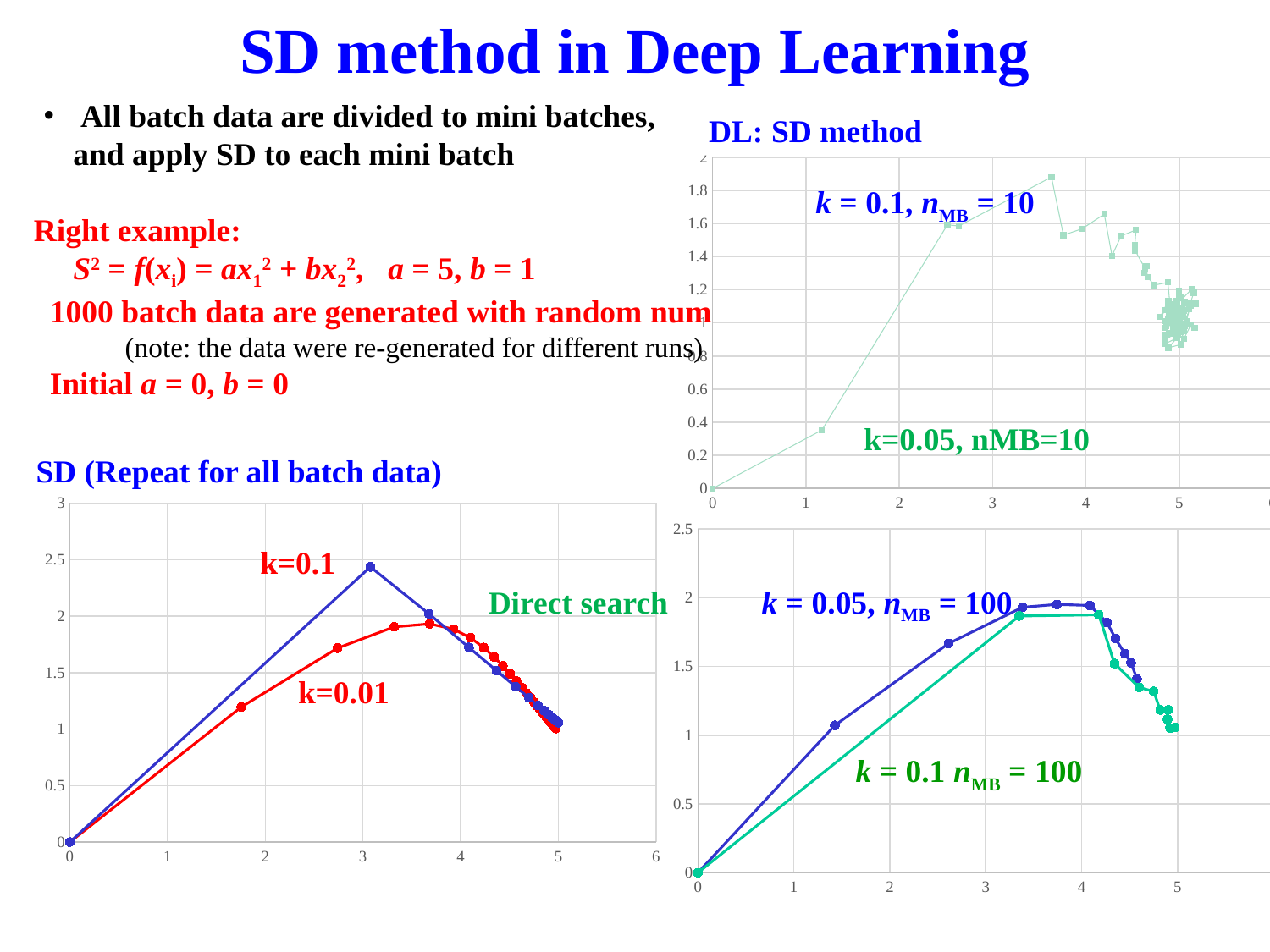
In the bottom-left chart 'SD (Repeat for all batch data)', at what x value do both curves start? 0 In the bottom-left chart 'SD (Repeat for all batch data)', is the peak value of the k=0.01 curve greater or less than 2? less In the bottom-right chart, is the peak value of the k = 0.05, nMB = 100 curve greater or less than 1.5? greater In the bottom-left chart 'SD (Repeat for all batch data)', how many curves are plotted? 2 In the bottom-right chart, which series is drawn in green? k = 0.1 nMB = 100 What is the title of the top-right chart? DL: SD method What kind of chart is the bottom-left chart titled 'SD (Repeat for all batch data)'? line chart In the bottom-left chart 'SD (Repeat for all batch data)', is the peak value of the k=0.1 curve greater or less than 2? greater In the bottom-right chart, how many series are plotted? 2 In the bottom-left chart 'SD (Repeat for all batch data)', which curve reaches a higher peak, k=0.1 or k=0.01? k=0.1 In the top-right chart 'DL: SD method', how many series are labelled? 2